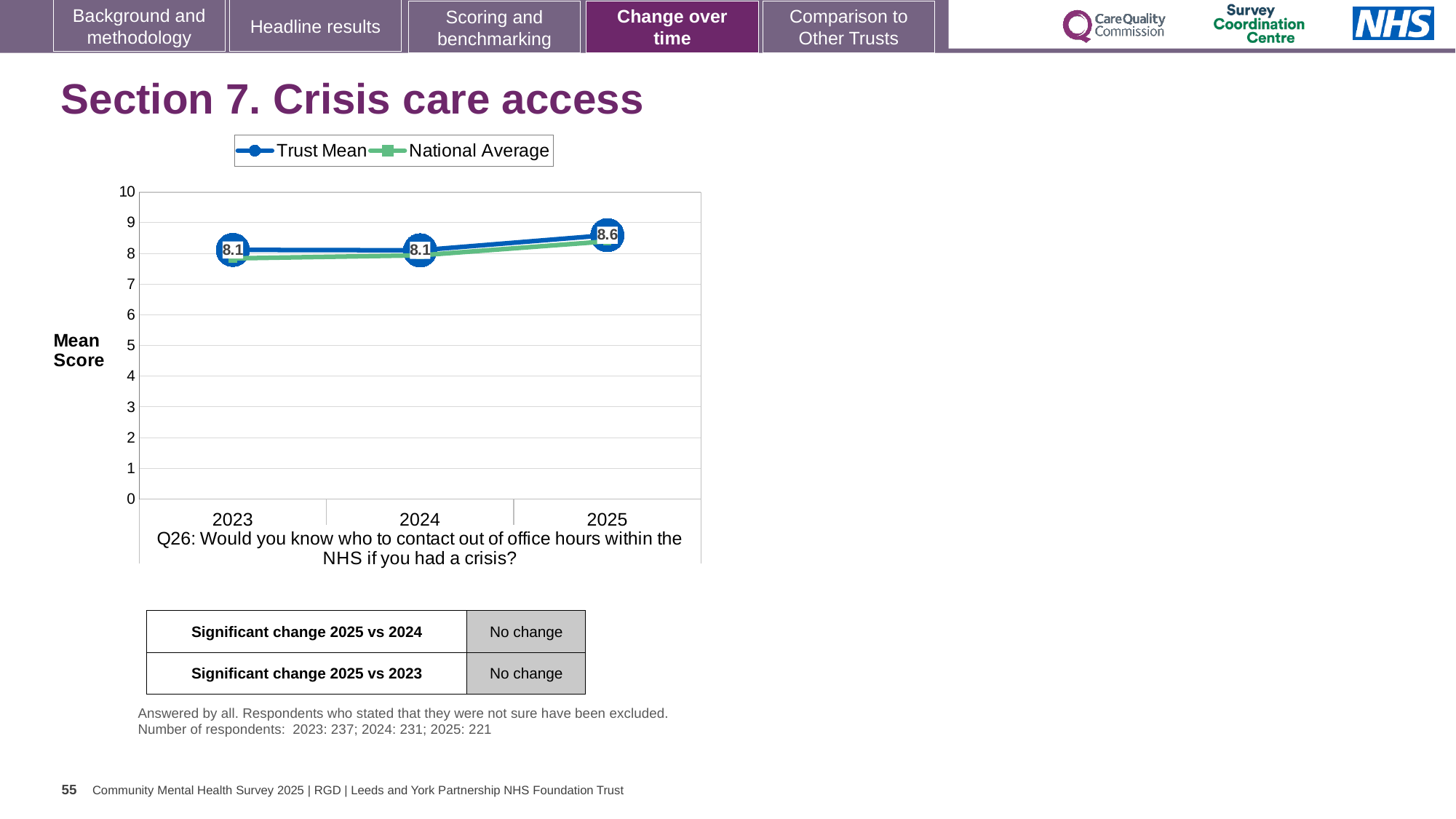
What is the Trust Mean value for 2025? 8.6 How many series does the legend list? 2 What is the label on the y axis of the chart? Mean Score What is the Trust Mean value for 2024? 8.1 What is the Trust Mean value for 2023? 8.1 Which is larger, the Trust Mean for 2025 or for 2024? 2025 What is the difference between the Trust Mean in 2025 and in 2023? 0.5 Does the Trust Mean rise or fall from 2024 to 2025? rise What kind of chart is shown on the slide? line chart How many years are shown on the x axis of the chart? 3 In which year is the Trust Mean highest? 2025 Is the National Average value for 2023 greater or less than 5? greater